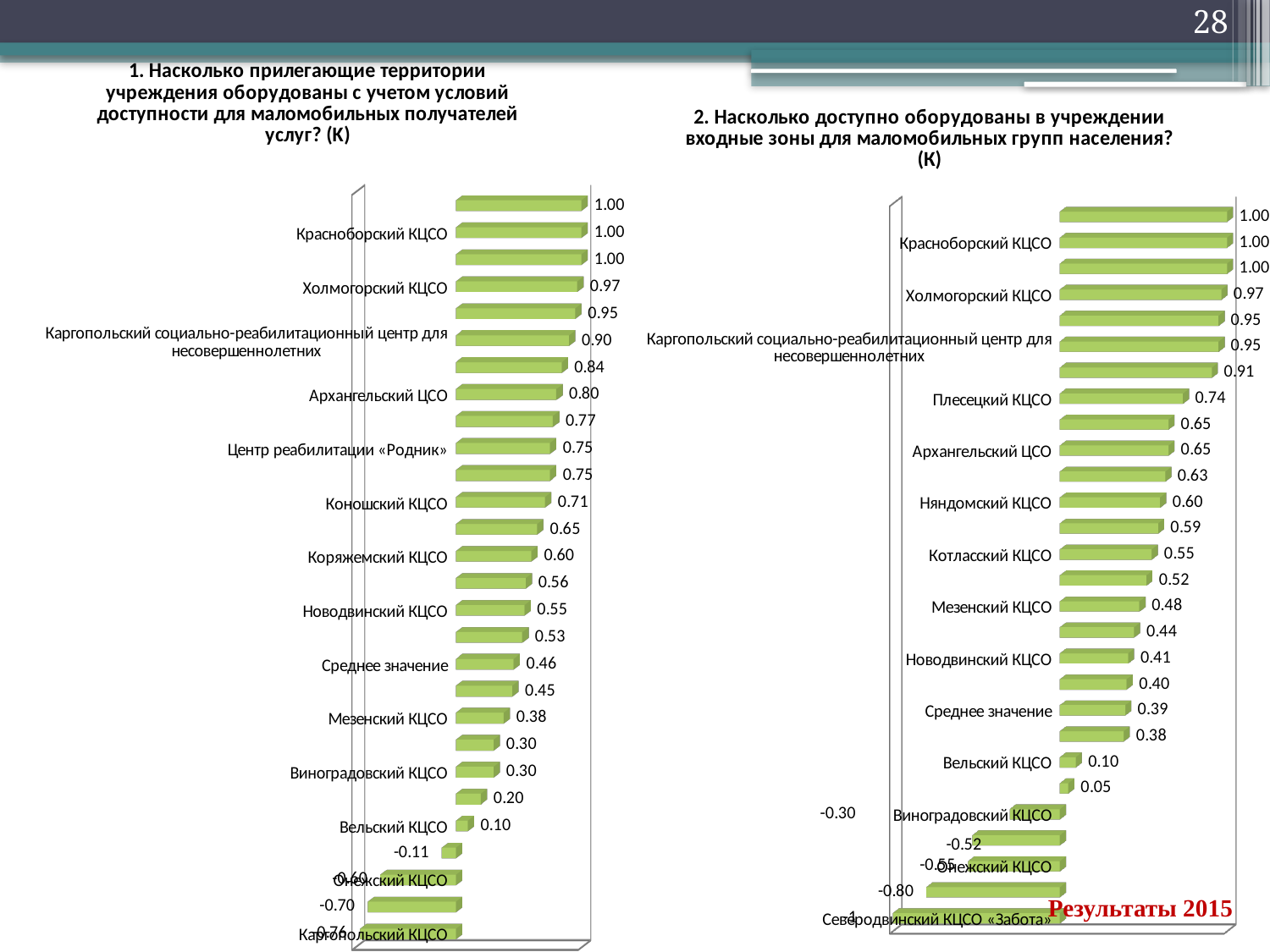
What type of chart is used on the left side of the slide (question 1)? Bar chart On the right chart (question 2, entrance zones), which is larger: the value for Няндомский КЦСО or the value for Мезенский КЦСО? Няндомский КЦСО On the right chart (question 2, entrance zones), what is the value for Виноградовский КЦСО? -0.30 On the left chart (question 1, adjacent territories), what is the value for Вельский КЦСО? 0.10 On the left chart (question 1, adjacent territories), what is the difference between the values for Архангельский ЦСО and Мезенский КЦСО? 0.42 On the left chart (question 1, adjacent territories), what is the value for Среднее значение? 0.46 On the right chart (question 2, entrance zones), what is the value for Плесецкий КЦСО? 0.74 On the left chart (question 1, adjacent territories), what is the value for Холмогорский КЦСО? 0.97 On the left chart (question 1, adjacent territories), what is the value for Коношский КЦСО? 0.71 On the right chart (question 2, entrance zones), which category has the lowest value? Северодвинский КЦСО «Забота» On the right chart (question 2, entrance zones), what is the value for Среднее значение? 0.39 On the right chart (question 2, entrance zones), what is the difference between the values for Холмогорский КЦСО and Котласский КЦСО? 0.42